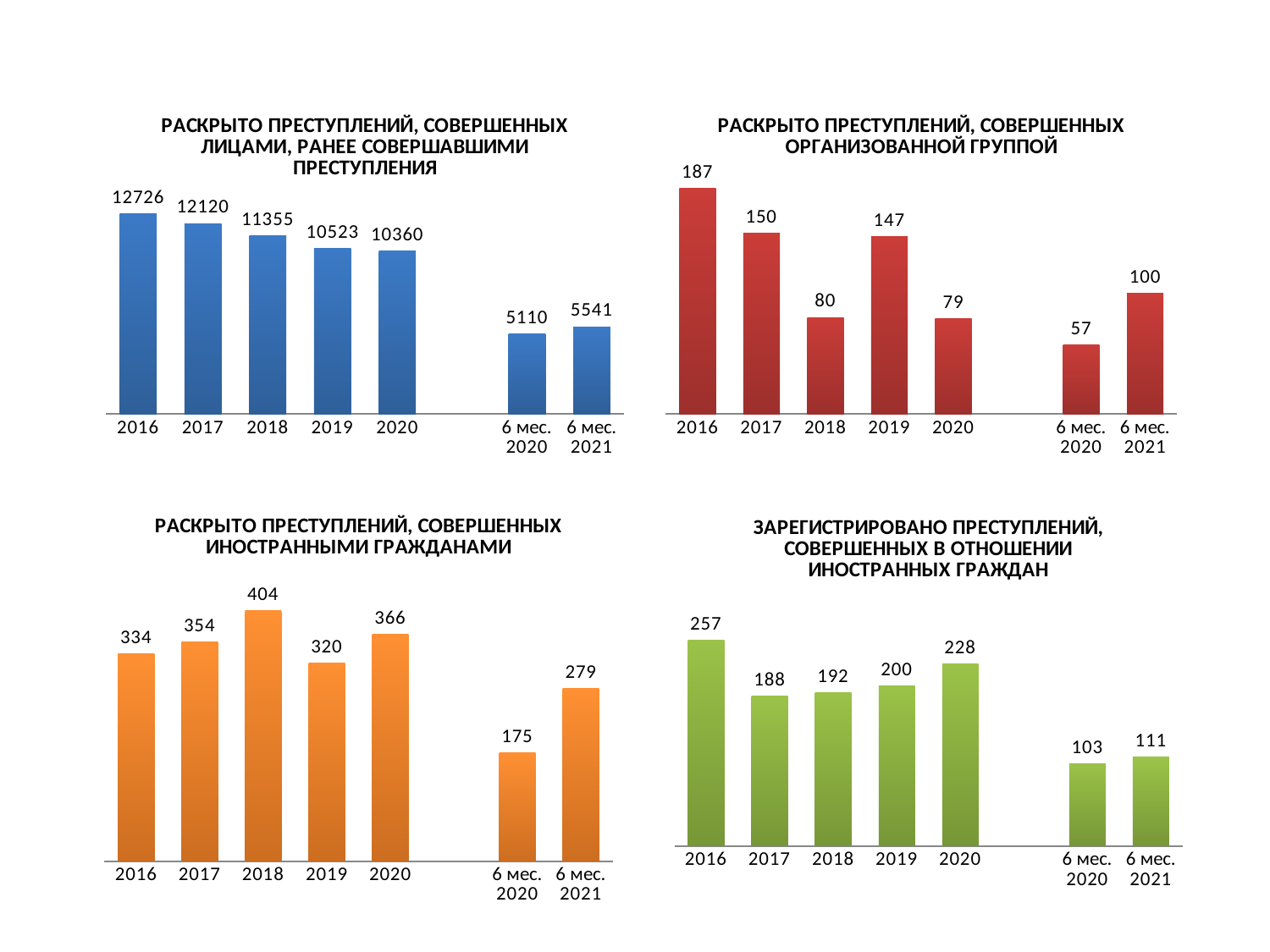
In the bottom-left chart (crimes solved committed by foreign citizens), which category has the highest value? 2018 In the top-left chart (crimes solved committed by persons who previously committed crimes), what is the value for 2018? 11355 In the top-right chart (crimes solved committed by an organized group), what is the value for 2019? 147 In the bottom-right chart (registered crimes committed against foreign citizens), what is the value for 2017? 188 In the top-right chart (crimes solved committed by an organized group), which is larger, the value for 2018 or the value for 2020? 2018 In the top-left chart (crimes solved committed by persons who previously committed crimes), what is the difference between the values for 6 мес. 2021 and 6 мес. 2020? 431 In the top-right chart (crimes solved committed by an organized group), which category has the lowest value? 6 мес. 2020 In the bottom-right chart (registered crimes committed against foreign citizens), how many bars are plotted? 7 In the top-left chart (crimes solved committed by persons who previously committed crimes), which category has the highest value? 2016 In the bottom-left chart (crimes solved committed by foreign citizens), what is the value for 2020? 366 In the bottom-left chart (crimes solved committed by foreign citizens), what is the difference between the values for 2018 and 2019? 84 What type of chart is the bottom-right chart (registered crimes committed against foreign citizens)? Bar chart